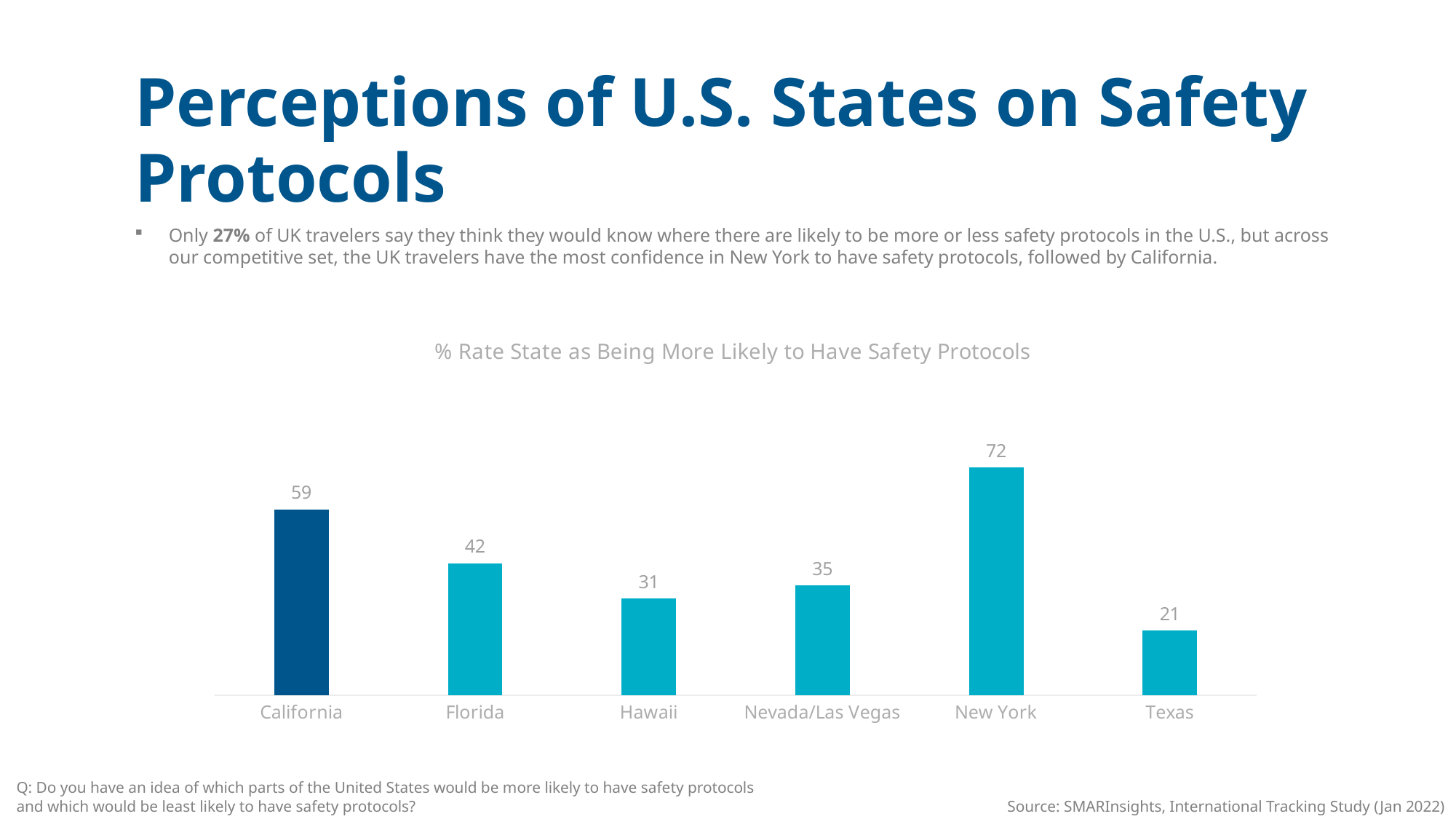
Which state has the lowest value? Texas Which has a larger value, Florida or Nevada/Las Vegas? Florida How many states are shown in the chart? 6 What is the difference between the values for Florida and Texas? 21 What is the value for Nevada/Las Vegas? 35 Which bar is shown in a darker blue than the others? California What is the difference between the values for New York and California? 13 What is the value for Hawaii? 31 What is the value for New York? 72 Which state has the highest value? New York What kind of chart is shown on the slide? Bar chart What is the title of the chart? % Rate State as Being More Likely to Have Safety Protocols